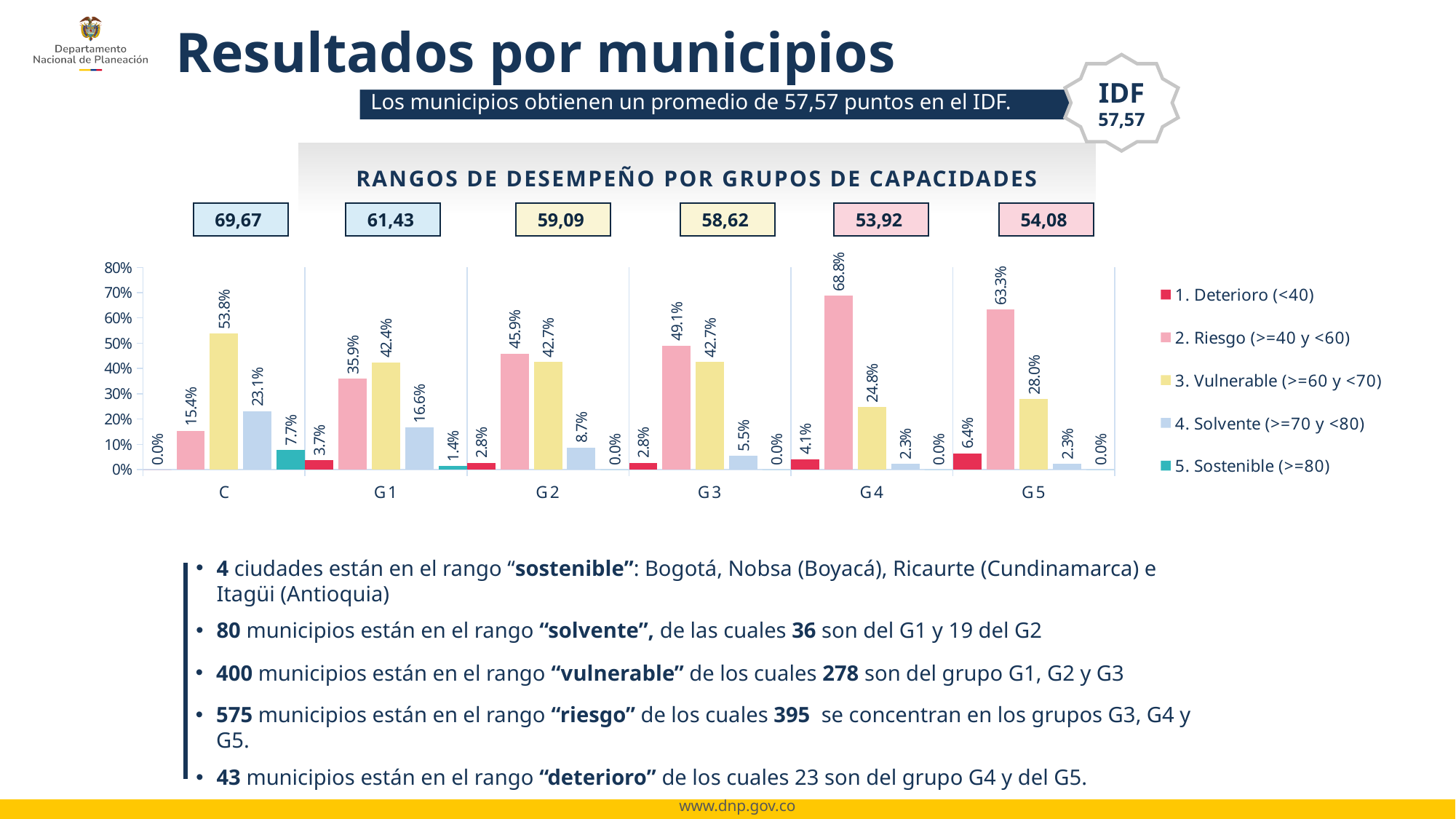
Which group has the lowest value for '1. Deterioro (<40)'? C What is the title of the chart? RANGOS DE DESEMPEÑO POR GRUPOS DE CAPACIDADES What type of chart is shown on the slide? bar chart What is the difference between the '2. Riesgo (>=40 y <60)' values for G4 and G5? 5.5% What is the value for '2. Riesgo (>=40 y <60)' in group G4? 68.8% What is the value for '3. Vulnerable (>=60 y <70)' in group C? 53.8% How many series does the legend list? 5 Which is larger in group G2: '2. Riesgo (>=40 y <60)' or '3. Vulnerable (>=60 y <70)'? 2. Riesgo (>=40 y <60) What is the value for '5. Sostenible (>=80)' in group G1? 1.4% Which group has the highest value for '2. Riesgo (>=40 y <60)'? G4 How many groups (categories) are shown on the x axis? 6